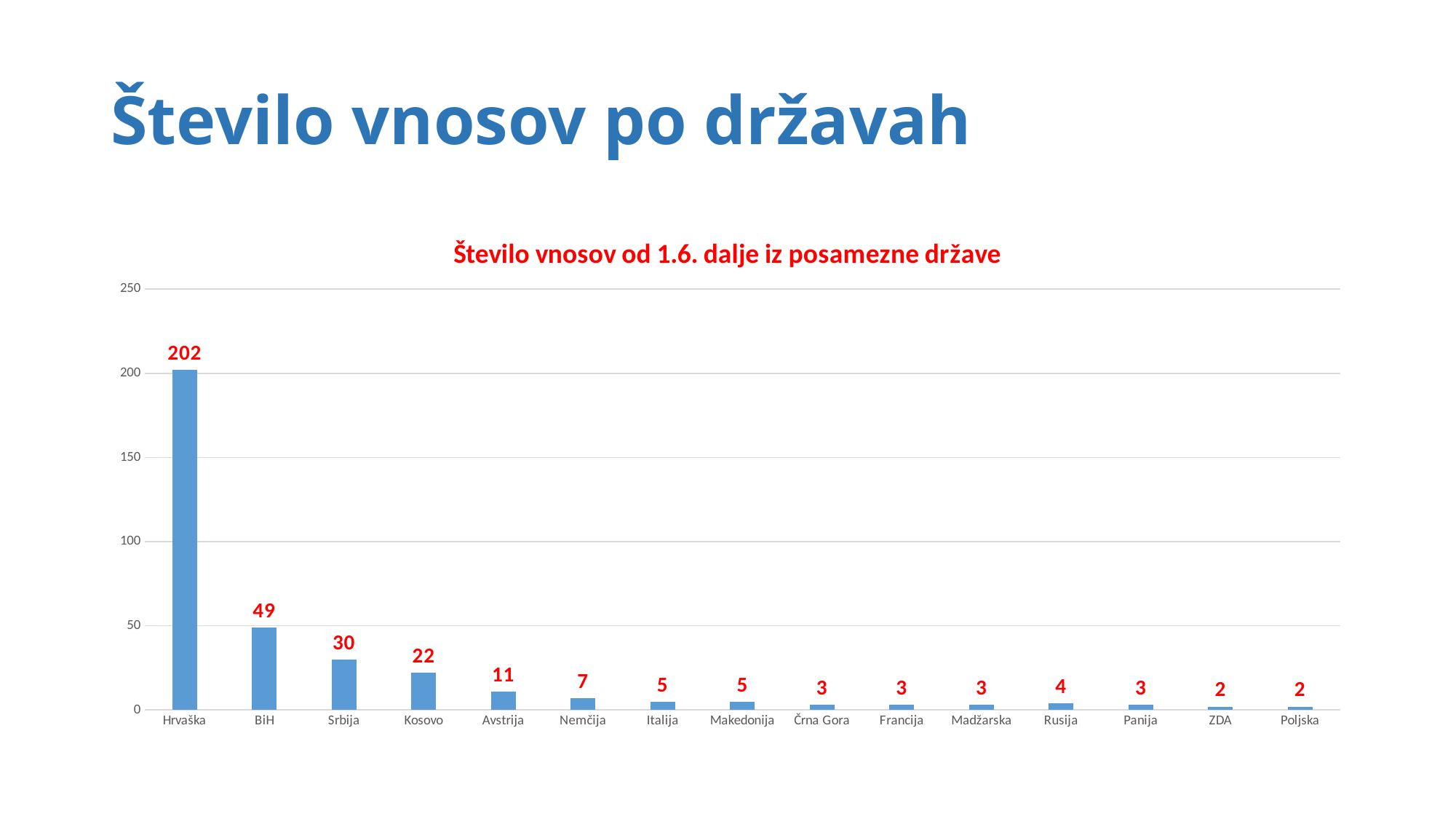
What is the title of the chart? Število vnosov od 1.6. dalje iz posamezne države Is the value for Hrvaška greater or less than 200? greater Which is larger, the value for Avstrija or the value for Nemčija? Avstrija Which country has the highest number of entries? Hrvaška What is the difference between the values for Hrvaška and BiH? 153 Do the values generally rise or fall from left to right along the x axis? fall What is the value for Rusija? 4 What is the difference between the values for BiH and Srbija? 19 What kind of chart is shown on the slide? bar chart What is the value for Kosovo? 22 How many countries are shown on the x axis? 15 What is the value for Hrvaška? 202